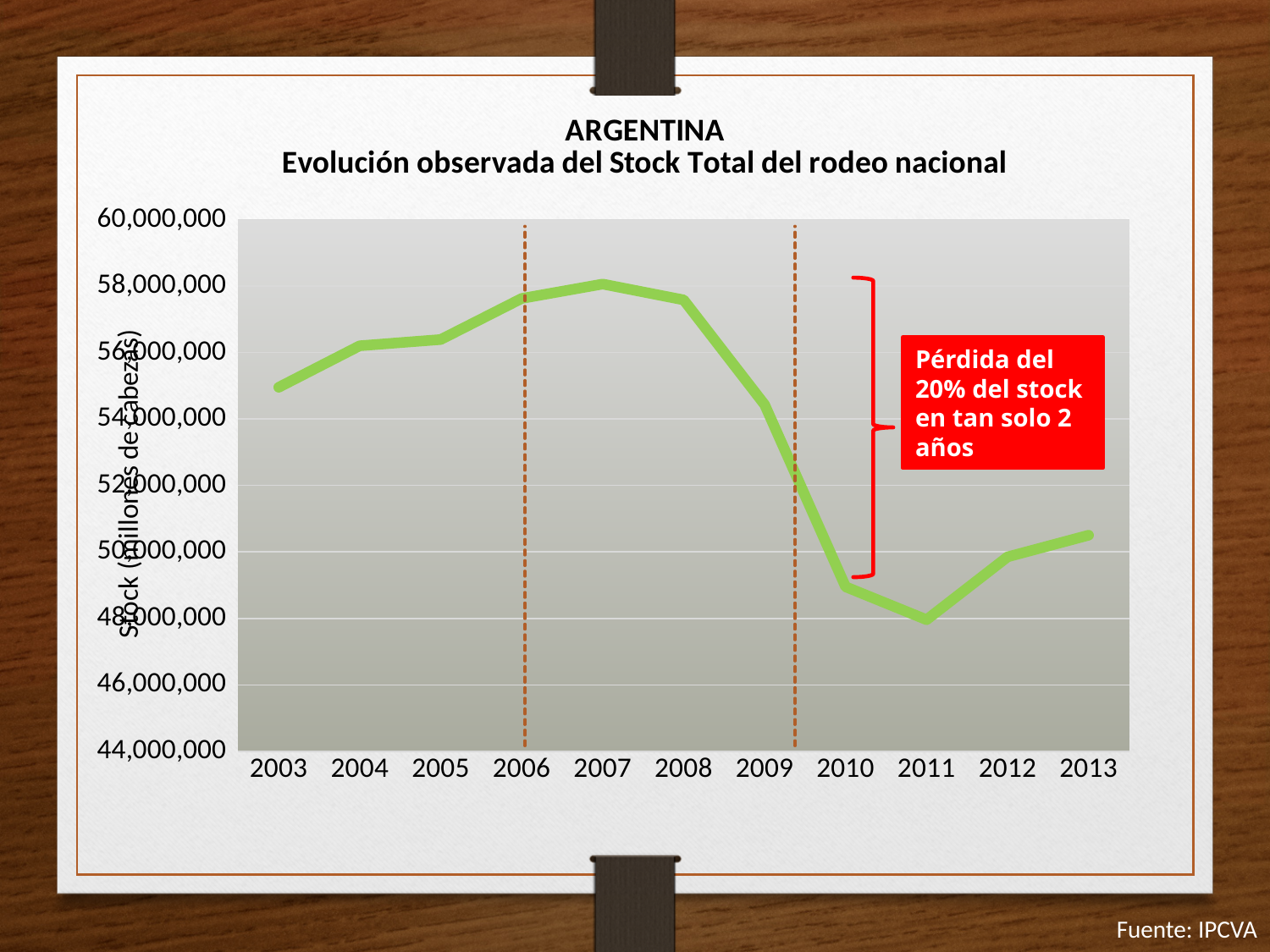
Does the stock rise or fall between 2011 and 2013? rise Is the value for 2007 greater or less than 56,000,000? greater In which year does the stock reach its lowest value? 2011 In which year does the stock reach its highest value? 2007 Is the value for 2003 greater or less than 54,000,000? greater What kind of chart is shown on the slide? line chart Does the stock rise or fall between 2007 and 2011? fall Is the value for 2011 greater or less than 50,000,000? less Which year has the larger stock value, 2003 or 2013? 2003 What does the red annotation box on the chart say? Pérdida del 20% del stock en tan solo 2 años How many years are plotted along the x axis? 11